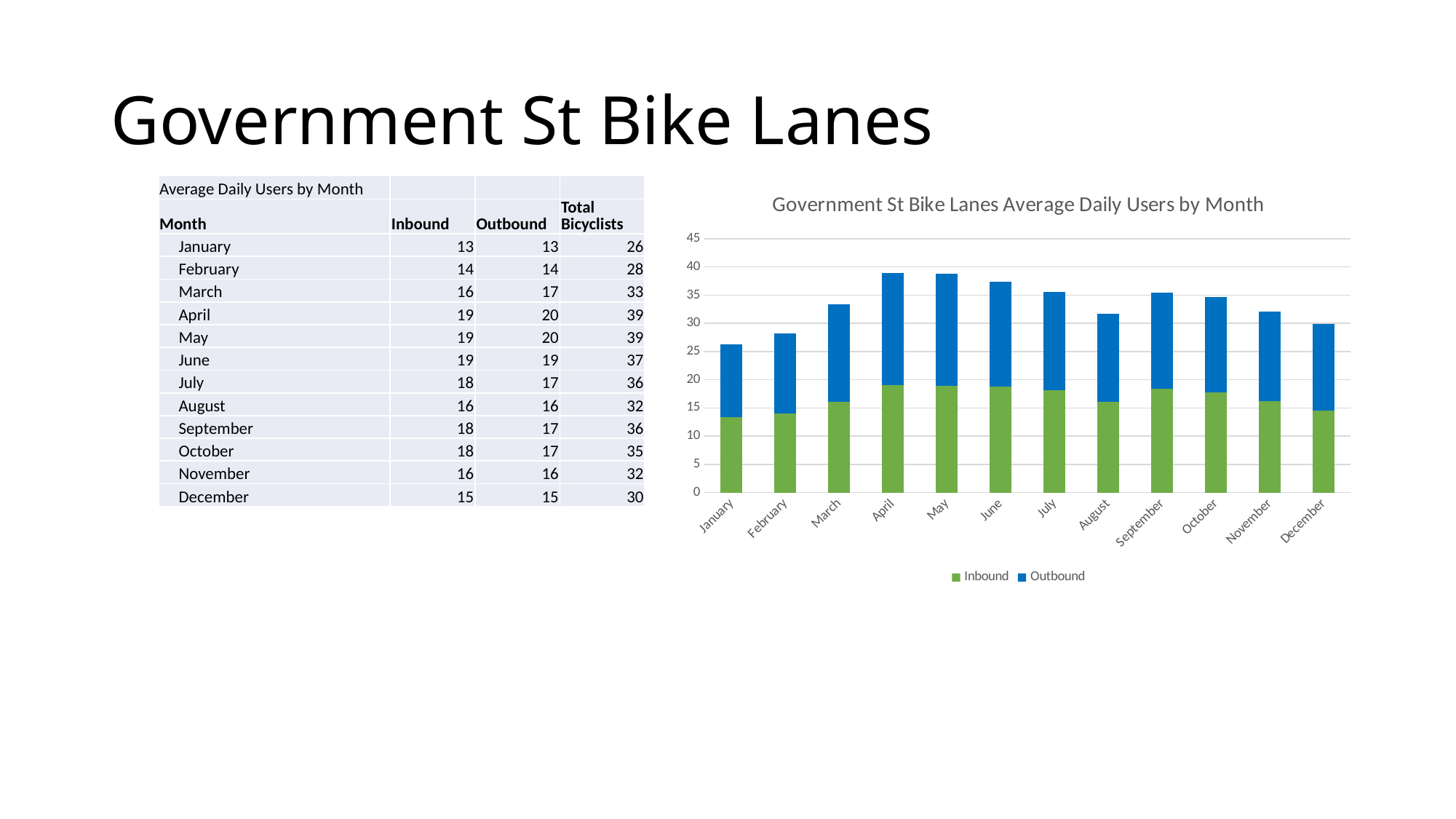
What is the difference between the total bicyclists in April and in January? 13 Which is larger, the total bicyclists for July or for November? July What kind of chart is shown on the slide? Stacked bar chart Do the total values rise or fall from January to April? Rise What is the Outbound value for December? 15 Is the total value for January greater or less than 30? less How many series does the chart legend list? 2 Which colour represents the Inbound series in the chart? Green Which month has the lowest total number of bicyclists? January How many months are plotted along the x axis of the chart? 12 What is the total of the stacked bar for June? 37 What is the Inbound value for April? 19